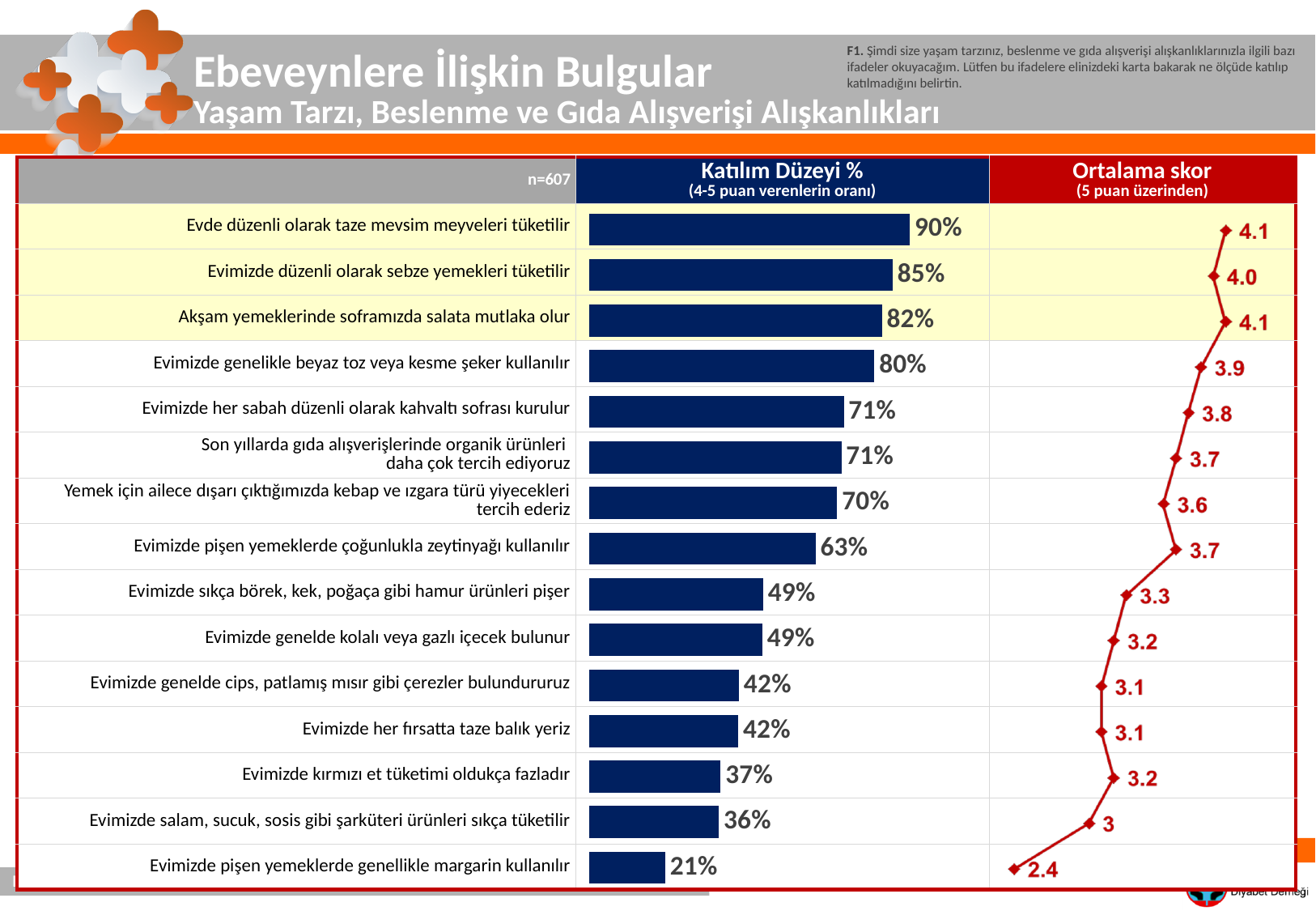
In the Ortalama skor chart, what is the score for "Evimizde sıkça börek, kek, poğaça gibi hamur ürünleri pişer"? 3.3 In the Ortalama skor chart, which statement has the lowest score? Evimizde pişen yemeklerde genellikle margarin kullanılır In the Katılım Düzeyi % chart, which statement has the lowest value? Evimizde pişen yemeklerde genellikle margarin kullanılır In the Ortalama skor chart, what is the score for "Evimizde salam, sucuk, sosis gibi şarküteri ürünleri sıkça tüketilir"? 3 In the Katılım Düzeyi % chart, what is the difference between "Evimizde düzenli olarak sebze yemekleri tüketilir" and "Evimizde kırmızı et tüketimi oldukça fazladır"? 48% In the Katılım Düzeyi % chart, what is the value for "Evimizde pişen yemeklerde çoğunlukla zeytinyağı kullanılır"? 63% In the Katılım Düzeyi % chart, what is the value for "Evde düzenli olarak taze mevsim meyveleri tüketilir"? 90% In the Ortalama skor chart, what is the difference between the scores for "Evimizde genellikle beyaz toz veya kesme şeker kullanılır" and "Evimizde genelde kolalı veya gazlı içecek bulunur"? 0.7 In the Katılım Düzeyi % chart, which statement has the highest value? Evde düzenli olarak taze mevsim meyveleri tüketilir How many statements are plotted in the Katılım Düzeyi % chart? 15 In the Katılım Düzeyi % chart, which is larger: "Evimizde her sabah düzenli olarak kahvaltı sofrası kurulur" or "Evimizde her fırsatta taze balık yeriz"? Evimizde her sabah düzenli olarak kahvaltı sofrası kurulur What kind of chart is the Katılım Düzeyi % chart? Bar chart